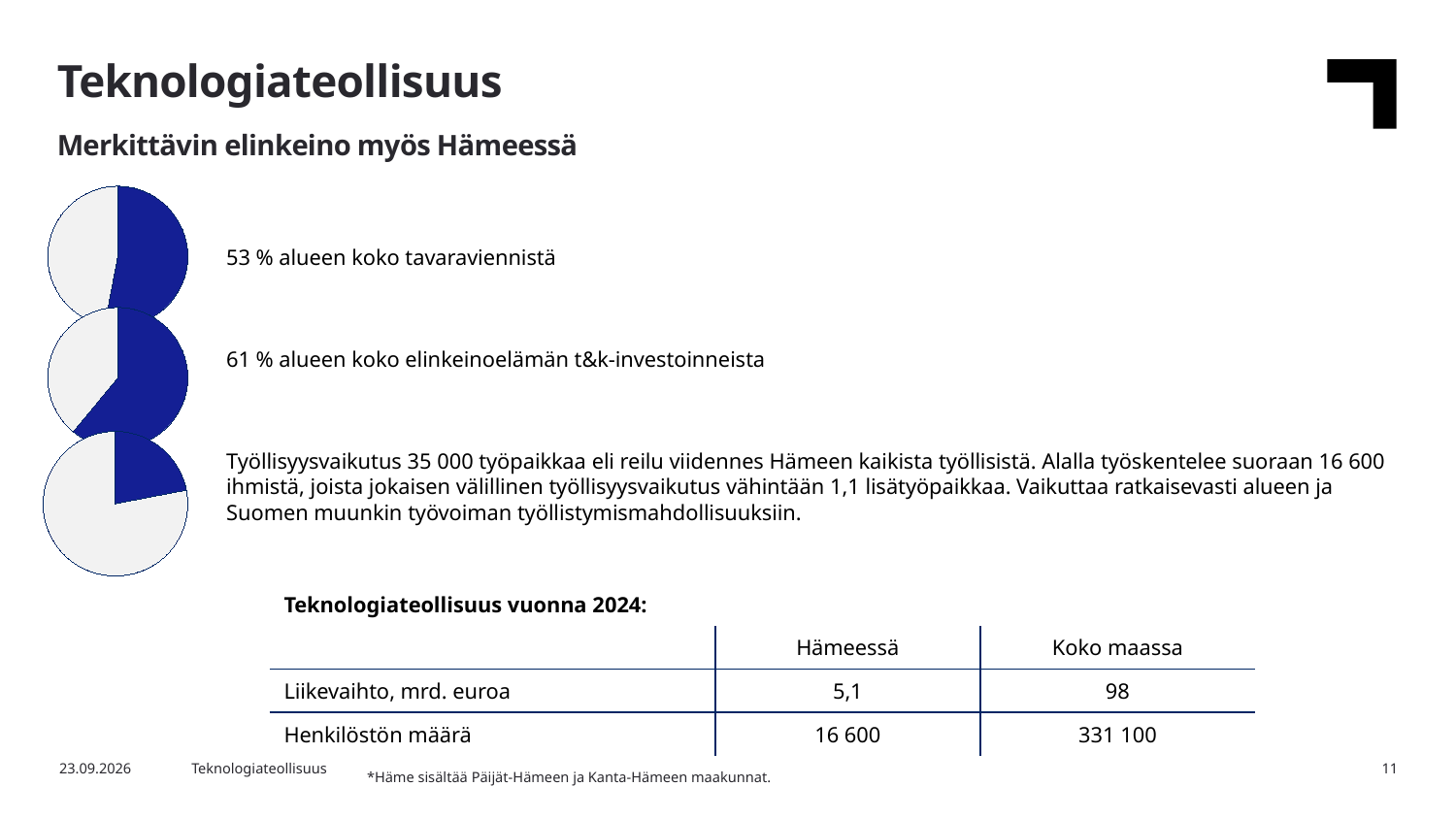
How many slices does each pie chart have? 2 In the top pie chart, what share of the region's total goods exports does the blue slice represent? 53 % How many pie charts are on the slide? 3 What colour is the highlighted slice in each pie chart? Dark blue Is the blue slice in the bottom pie chart greater or less than half of the pie? less Which of the three pie charts has the smallest blue slice? The bottom one (työllisyysvaikutus) Which pie chart has the larger blue slice, the top one (tavaravienti) or the middle one (t&k-investoinnit)? The middle one (t&k-investoinnit) In the middle pie chart, what share of the region's business R&D investments does the blue slice represent? 61 % What is the difference in percentage points between the blue slices of the middle and top pie charts? 8 percentage points What kind of charts are shown on the left side of the slide? Pie charts Which of the three pie charts has the largest blue slice? The middle one (t&k-investoinnit) Is the blue slice in the middle pie chart greater or less than half of the pie? greater